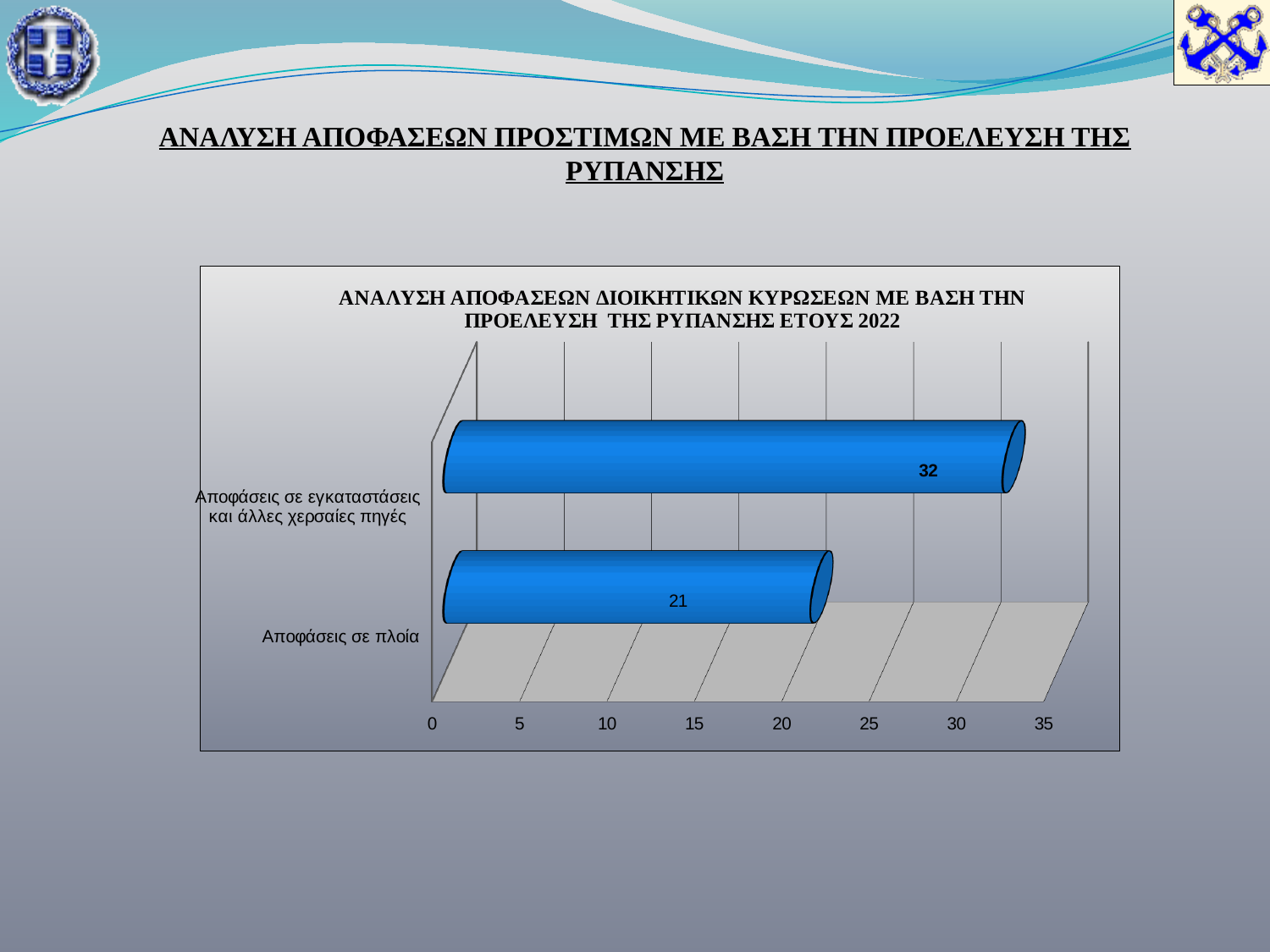
What is the value for Αποφάσεις σε εγκαταστάσεις και άλλες χερσαίες πηγές? 32 Is the value for Αποφάσεις σε εγκαταστάσεις και άλλες χερσαίες πηγές greater or less than 30? greater What kind of chart is shown on the slide? Bar chart What is the difference between the value for Αποφάσεις σε εγκαταστάσεις και άλλες χερσαίες πηγές and the value for Αποφάσεις σε πλοία? 11 Is the value for Αποφάσεις σε πλοία greater or less than 25? less What is the title of the chart? ΑΝΑΛΥΣΗ ΑΠΟΦΑΣΕΩΝ ΔΙΟΙΚΗΤΙΚΩΝ ΚΥΡΩΣΕΩΝ ΜΕ ΒΑΣΗ ΤΗΝ ΠΡΟΕΛΕΥΣΗ ΤΗΣ ΡΥΠΑΝΣΗΣ ΕΤΟΥΣ 2022 What is the total of the two values shown in the chart? 53 Which category has the lowest value? Αποφάσεις σε πλοία What is the value for Αποφάσεις σε πλοία? 21 Which is larger: the value for Αποφάσεις σε πλοία or the value for Αποφάσεις σε εγκαταστάσεις και άλλες χερσαίες πηγές? Αποφάσεις σε εγκαταστάσεις και άλλες χερσαίες πηγές How many categories are shown in the chart? 2 Which category has the highest value? Αποφάσεις σε εγκαταστάσεις και άλλες χερσαίες πηγές